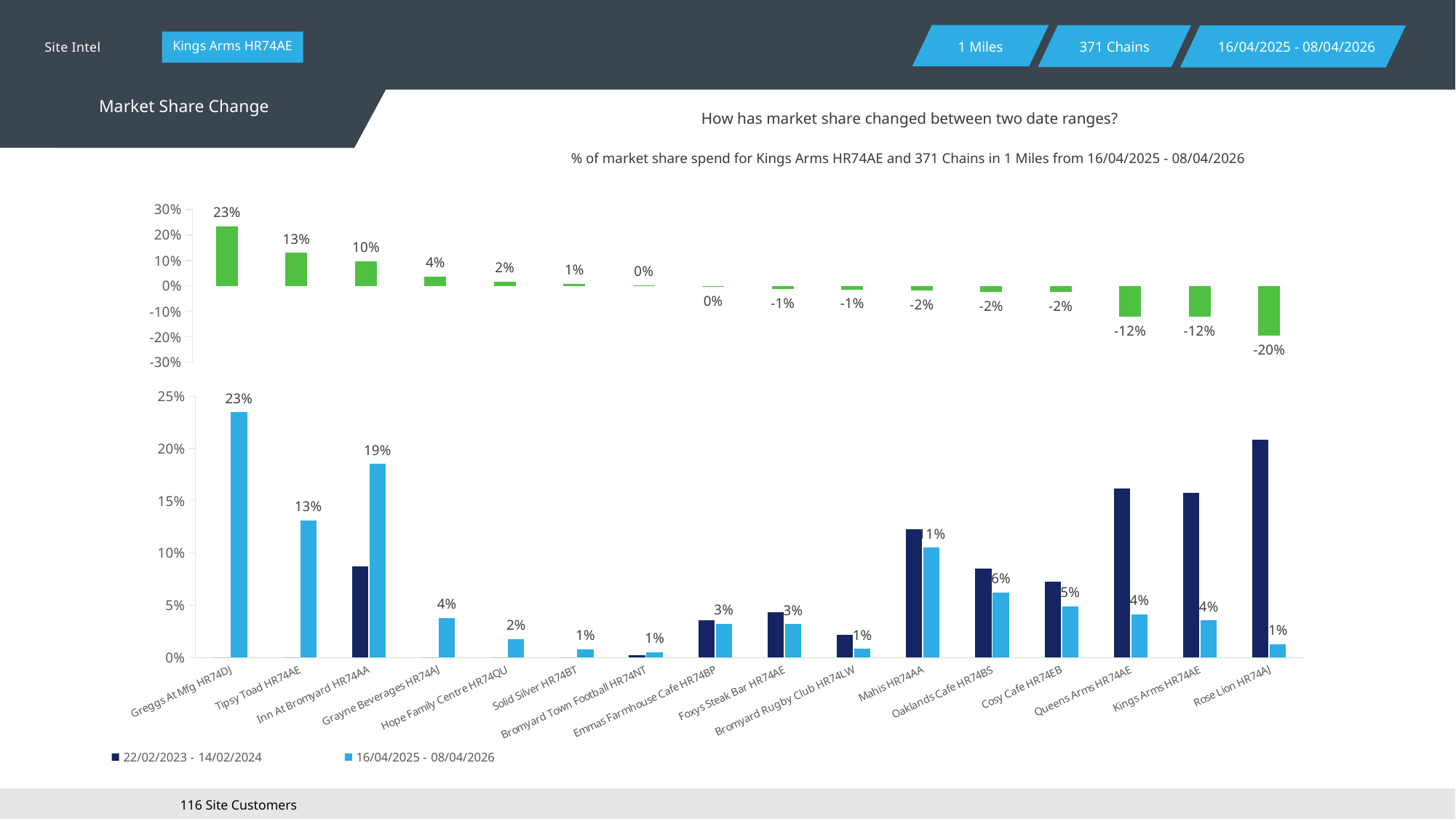
On the bottom chart, what is the difference between the 16/04/2025 - 08/04/2026 values for Greggs At Mfg HR74DJ and Tipsy Toad HR74AE? 10% On the bottom chart, is the value for Mahis HR74AA in the 22/02/2023 - 14/02/2024 series greater or less than 10%? greater What kind of chart is the bottom chart? Bar chart On the bottom chart, what is the value for Greggs At Mfg HR74DJ in the 16/04/2025 - 08/04/2026 series? 23% On the top chart, what is the highest value shown? 23% On the bottom chart, what is the value for Inn At Bromyard HR74AA in the 16/04/2025 - 08/04/2026 series? 19% On the top chart, what is the lowest value shown? -20% How many series does the legend of the bottom chart list? 2 How many categories are shown on the x axis of the bottom chart? 16 On the bottom chart, for Inn At Bromyard HR74AA, which series has the larger value? 16/04/2025 - 08/04/2026 On the bottom chart, which category has the highest value in the 16/04/2025 - 08/04/2026 series? Greggs At Mfg HR74DJ On the bottom chart, what is the value for Oaklands Cafe HR74BS in the 16/04/2025 - 08/04/2026 series? 6%